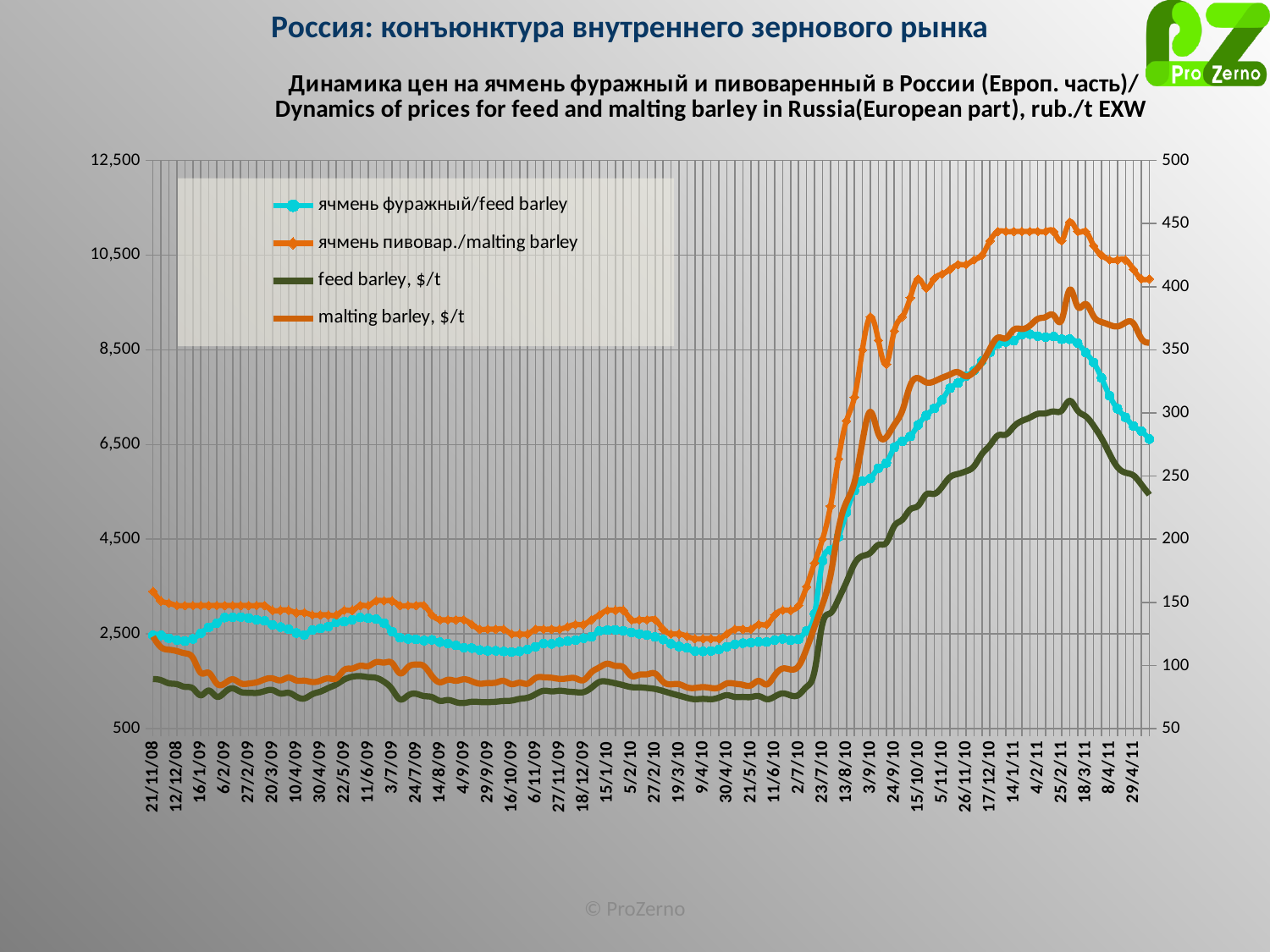
What is the English part of the chart title? Dynamics of prices for feed and malting barley in Russia(European part), rub./t EXW Is the value of the 'ячмень пивовар./malting barley' series at 21/11/08 greater or less than 2,500 on the left axis? greater Which legend entry is drawn in cyan (light blue)? ячмень фуражный/feed barley What is the highest value shown on the left vertical axis? 12,500 What is the first date label on the horizontal axis? 21/11/08 How many series does the legend list? 4 What is the highest value shown on the right vertical axis? 500 Is the value of the 'ячмень фуражный/feed barley' series at 14/1/11 greater or less than 6,500 on the left axis? greater Does the 'ячмень фуражный/feed barley' series rise or fall between 2/7/10 and 14/1/11? rise Which series is higher at 25/2/11: 'ячмень пивовар./malting barley' or 'ячмень фуражный/feed barley'? ячмень пивовар./malting barley What kind of chart is shown on the slide? line chart